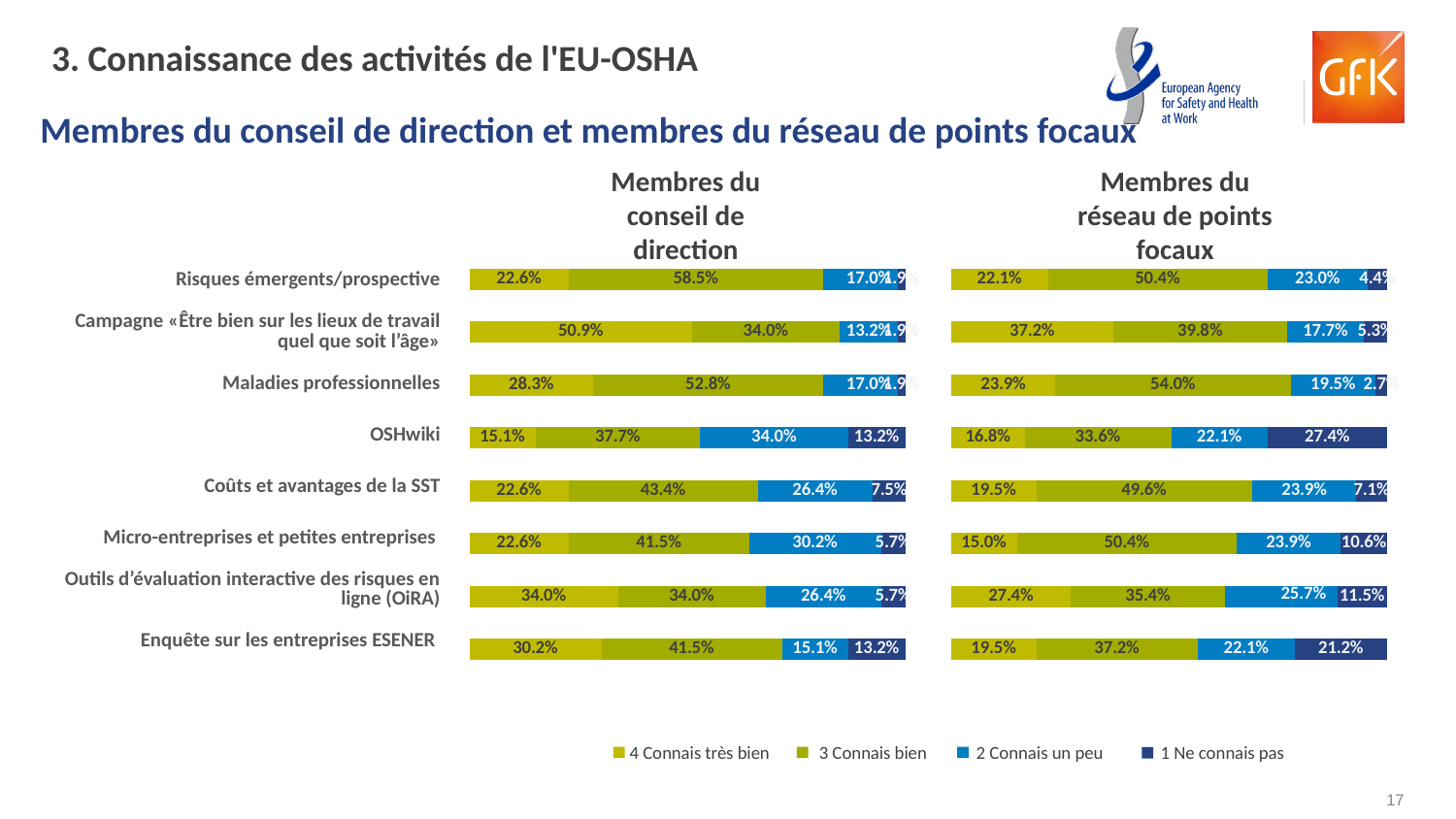
In the 'Membres du réseau de points focaux' chart, which category has the lowest value for '4 Connais très bien'? Micro-entreprises et petites entreprises What type of chart is used for 'Membres du réseau de points focaux'? Stacked bar chart In the 'Membres du conseil de direction' chart, which category has the highest value for '4 Connais très bien'? Campagne «Être bien sur les lieux de travail quel que soit l'âge» In the 'Membres du conseil de direction' chart, what is the value of '3 Connais bien' for 'Risques émergents/prospective'? 58.5% In the 'Membres du conseil de direction' chart, what is the value of '4 Connais très bien' for 'Campagne «Être bien sur les lieux de travail quel que soit l'âge»'? 50.9% How many categories are shown in the 'Membres du conseil de direction' chart? 8 In the 'Membres du conseil de direction' chart, what is the difference between the '3 Connais bien' values for 'Maladies professionnelles' and 'OSHwiki'? 15.1% How many series does the legend list? 4 In the 'Membres du réseau de points focaux' chart, what is the value of '1 Ne connais pas' for 'OSHwiki'? 27.4% In the 'Membres du réseau de points focaux' chart, what is the value of '2 Connais un peu' for 'Outils d'évaluation interactive des risques en ligne (OiRA)'? 25.7% In the 'Membres du réseau de points focaux' chart, which is larger: the '1 Ne connais pas' value for 'Enquête sur les entreprises ESENER' or for 'Micro-entreprises et petites entreprises'? Enquête sur les entreprises ESENER What is the title of the chart on the right side of the slide? Membres du réseau de points focaux